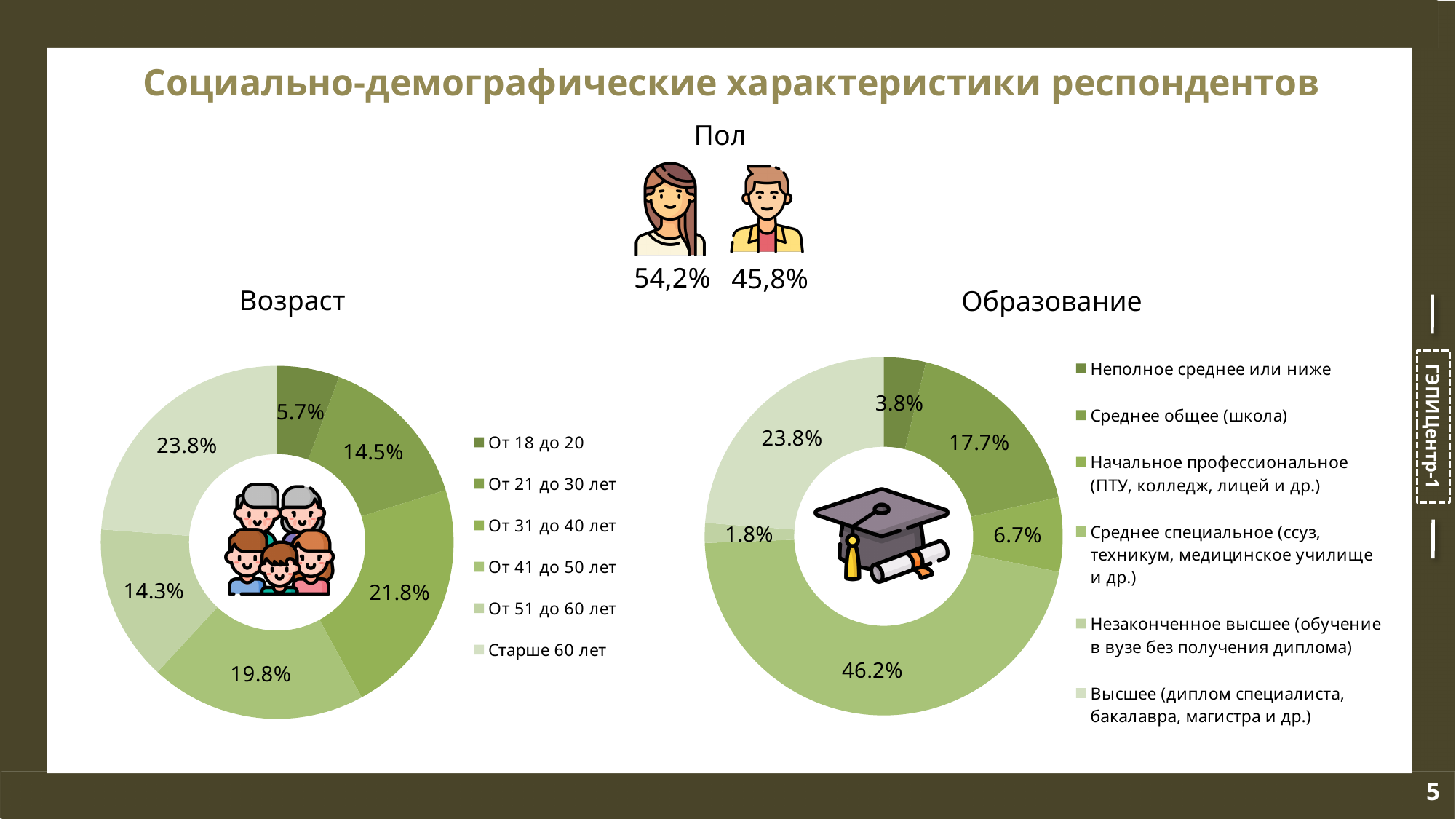
What type of chart is the "Образование" chart? Doughnut (pie) chart On the "Возраст" chart, what is the difference between the shares for "От 41 до 50 лет" and "От 51 до 60 лет"? 5.5% On the "Возраст" chart, which age group has the largest share? Старше 60 лет On the "Образование" chart, what is the difference between the shares for "Среднее специальное" and "Высшее"? 22.4% How many categories does the legend of the "Возраст" chart list? 6 On the "Возраст" chart, which age group has the smallest share? От 18 до 20 On the "Возраст" chart, what share is shown for "От 31 до 40 лет"? 21.8% On the "Образование" chart, which is larger: the share for "Неполное среднее или ниже" or for "Начальное профессиональное (ПТУ, колледж, лицей и др.)"? Начальное профессиональное (ПТУ, колледж, лицей и др.) On the "Образование" chart, which education level has the largest share? Среднее специальное (ссуз, техникум, медицинское училище и др.) On the "Образование" chart, what share is shown for "Среднее общее (школа)"? 17.7% On the "Возраст" chart, what share is shown for "От 18 до 20"? 5.7% On the "Образование" chart, what share is shown for "Незаконченное высшее (обучение в вузе без получения диплома)"? 1.8%